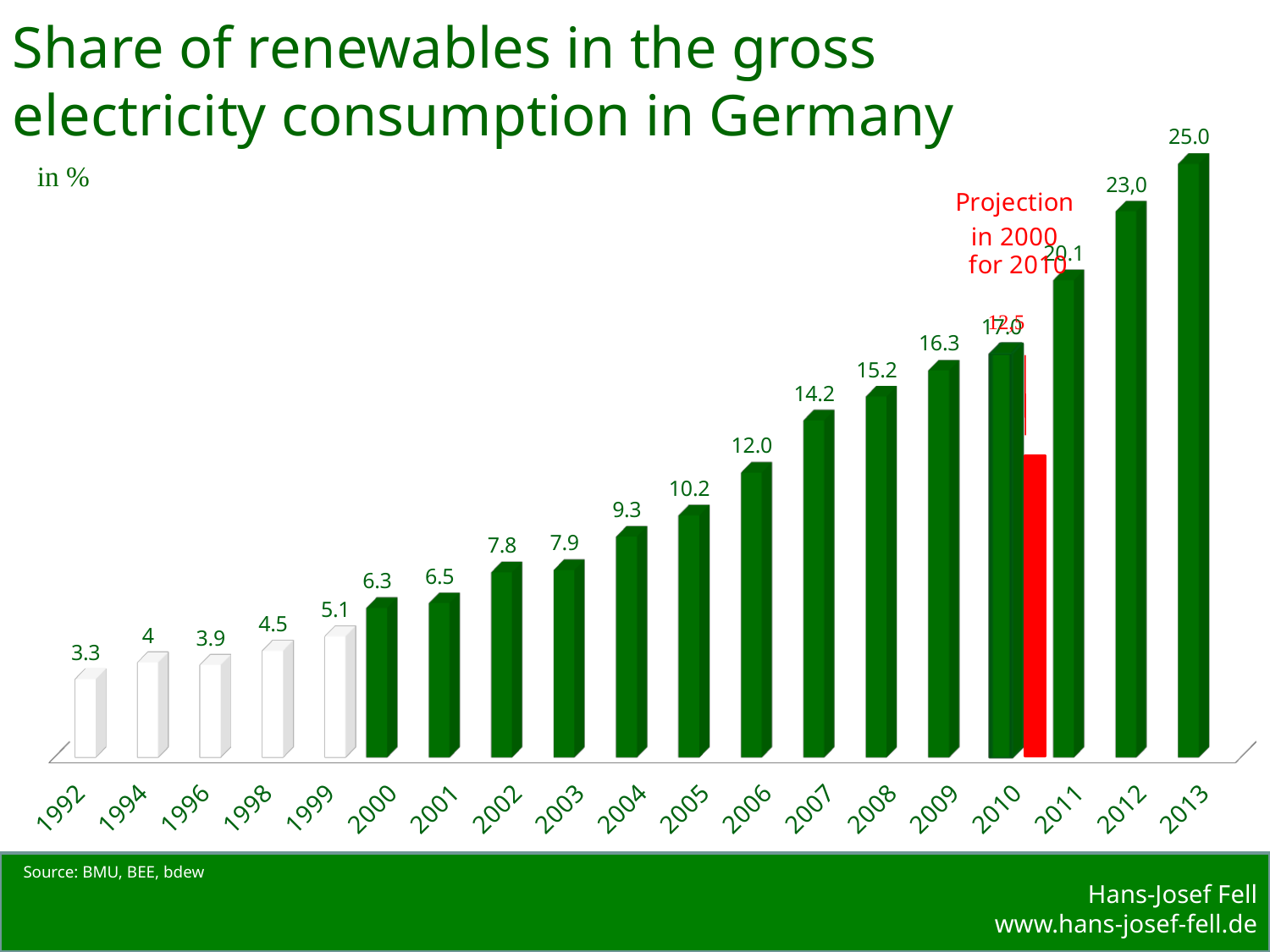
What is the difference between the values for 2006 and 2005? 1.8 What does the red bar represent? Projection in 2000 for 2010 What is the value for 1992? 3.3 Which year has the highest share of renewables? 2013 How many years are shown on the x axis? 19 What value is shown for 2007? 14.2 What value is labelled for 2012? 23,0 What kind of chart is this? Bar chart What is the difference between the values for 2013 and 2012? 2.0 Which year has the lowest share of renewables? 1992 What is the share of renewables in 2005? 10.2 Which is larger, the value for 2004 or the value for 2007? 2007